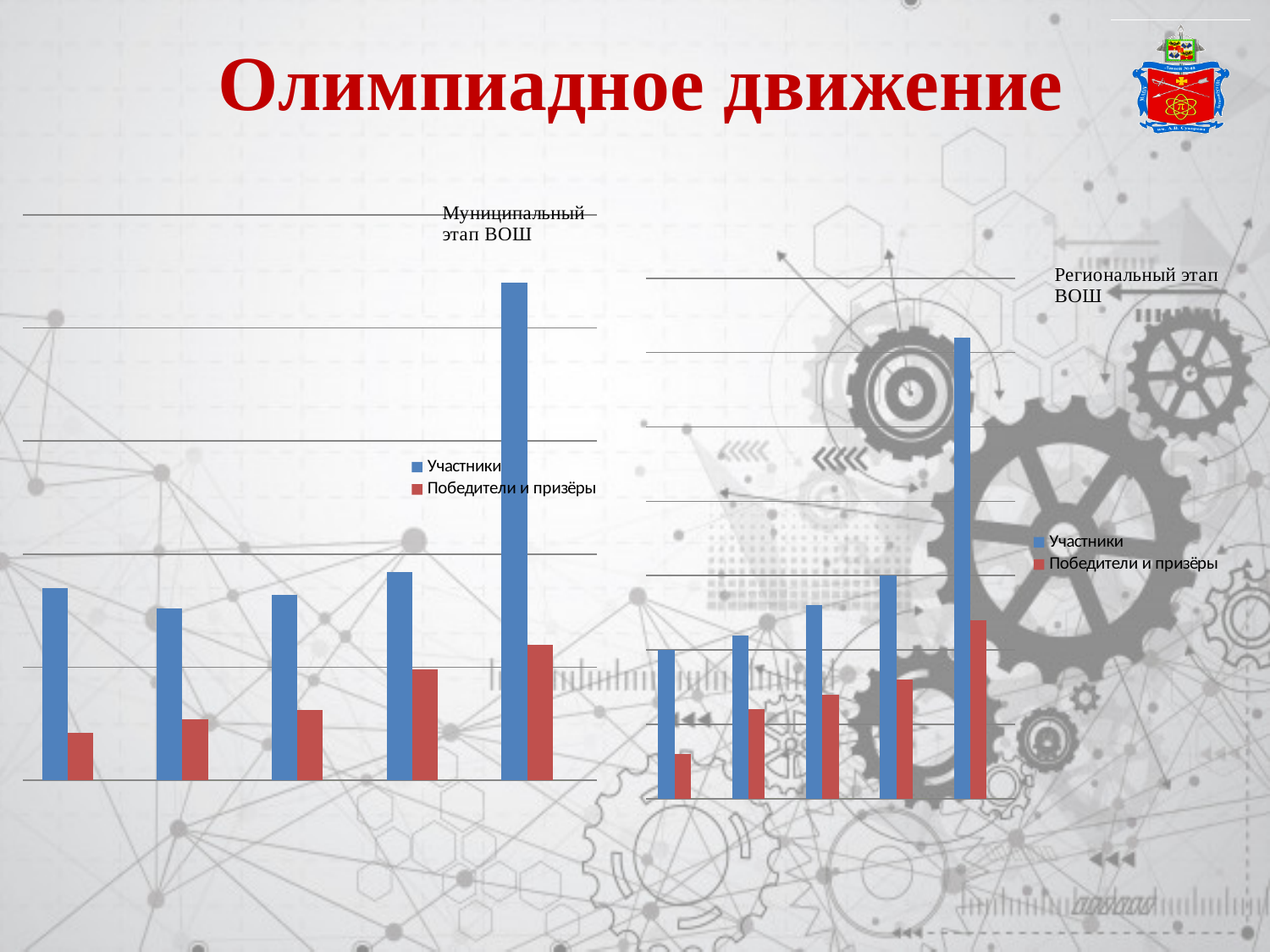
What are the two legend entries of the "Региональный этап ВОШ" chart? Участники; Победители и призёры In the "Региональный этап ВОШ" chart, do the "Участники" bars rise or fall from left to right? Rise In the "Муниципальный этап ВОШ" chart, what colour are the "Победители и призёры" bars? Red How many groups of bars are plotted in the "Муниципальный этап ВОШ" chart? 5 In the "Муниципальный этап ВОШ" chart, which group of bars has the tallest "Участники" bar? The rightmost (fifth) group How many groups of bars are plotted in the "Региональный этап ВОШ" chart? 5 What kind of chart is the "Муниципальный этап ВОШ" chart? Bar chart How many series does the legend of the "Региональный этап ВОШ" chart list? 2 What kind of chart is the "Региональный этап ВОШ" chart? Bar chart How many series does the legend of the "Муниципальный этап ВОШ" chart list? 2 In the "Региональный этап ВОШ" chart, which group of bars has the shortest "Победители и призёры" bar? The leftmost (first) group In the "Муниципальный этап ВОШ" chart, which series is larger in the rightmost group: "Участники" or "Победители и призёры"? Участники